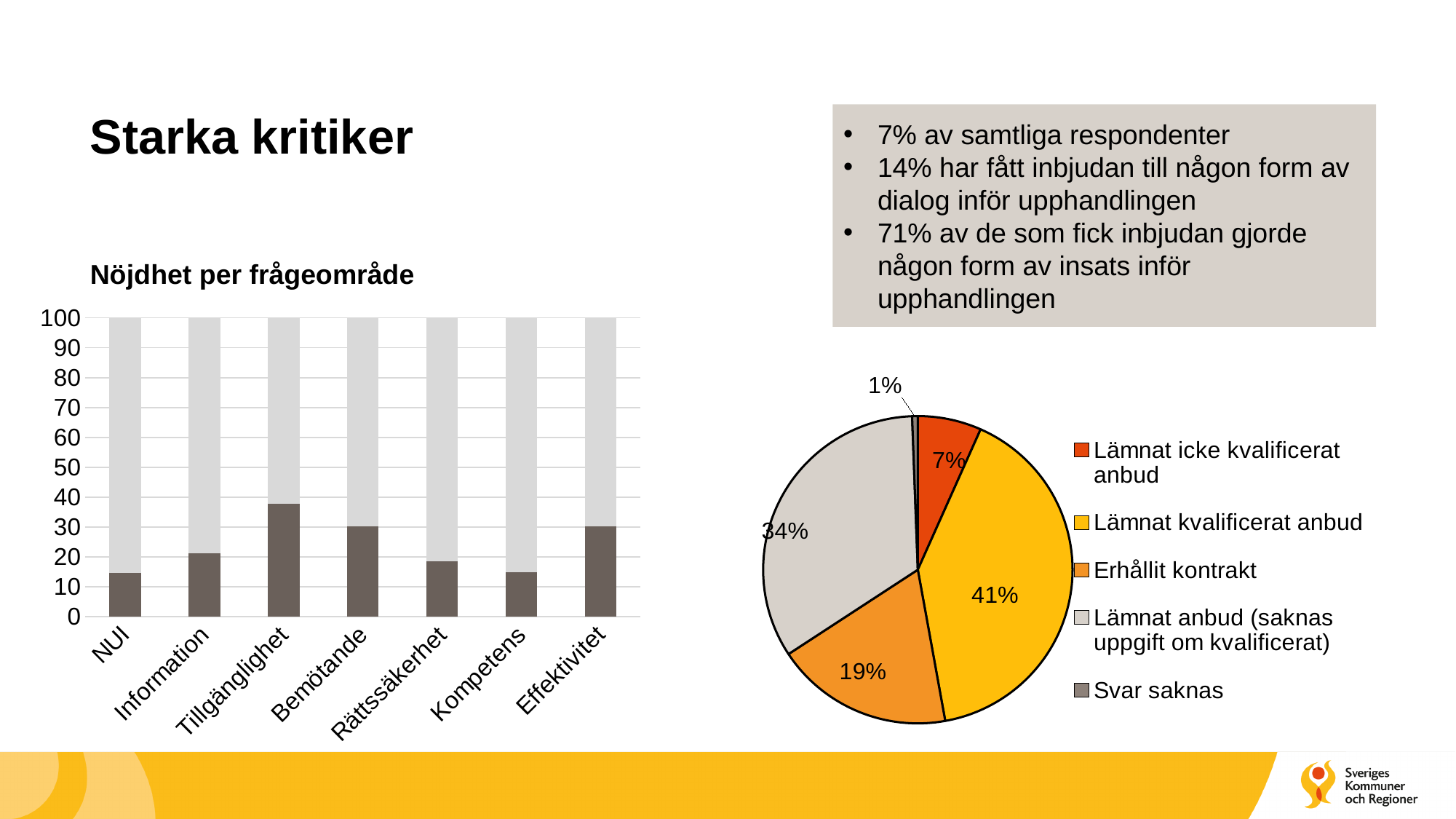
In the bar chart 'Nöjdhet per frågeområde', is the value for NUI greater or less than 20? less In the bar chart 'Nöjdhet per frågeområde', is the value for Information greater or less than 30? less In the pie chart on the right, which slice is the largest? Lämnat kvalificerat anbud In the bar chart 'Nöjdhet per frågeområde', which category has the highest value? Tillgänglighet What kind of chart is 'Nöjdhet per frågeområde'? bar chart In the bar chart 'Nöjdhet per frågeområde', is the value for Tillgänglighet greater or less than 30? greater How many entries does the legend of the pie chart on the right list? 5 In the pie chart on the right, what share is labelled for 'Erhållit kontrakt'? 19% In the pie chart on the right, what is the difference between the shares for 'Lämnat anbud (saknas uppgift om kvalificerat)' and 'Lämnat icke kvalificerat anbud'? 27% In the bar chart 'Nöjdhet per frågeområde', which is larger, the value for Tillgänglighet or the value for Kompetens? Tillgänglighet In the pie chart on the right, what share is labelled for 'Lämnat kvalificerat anbud'? 41% How many categories are shown on the x axis of the bar chart 'Nöjdhet per frågeområde'? 7